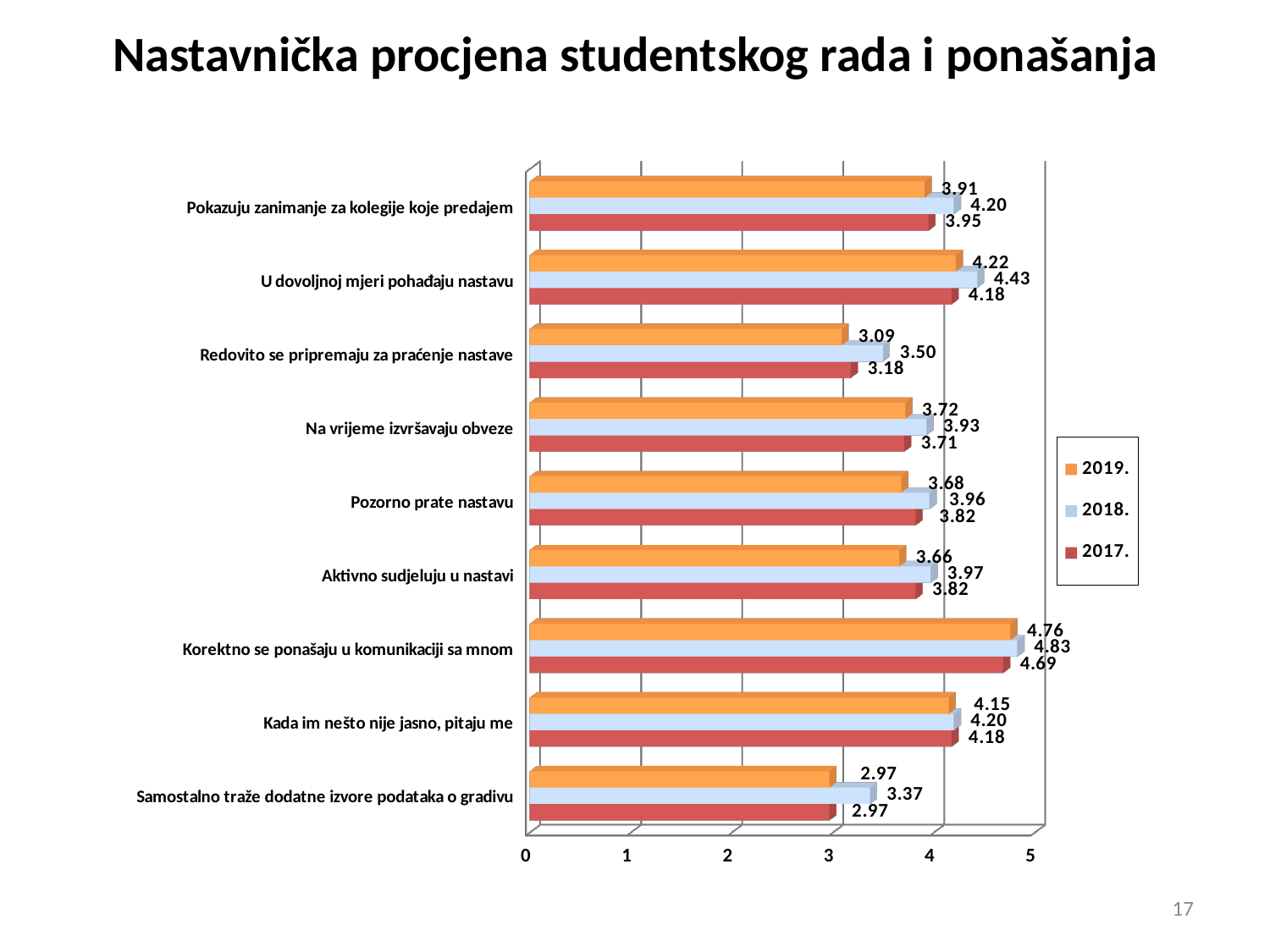
What is the 2019. value for "Pozorno prate nastavu"? 3.68 What is the 2018. value for "Redovito se pripremaju za praćenje nastave"? 3.50 What is the 2017. value for "Korektno se ponašaju u komunikaciji sa mnom"? 4.69 What is the difference between the 2018. and 2017. values for "Redovito se pripremaju za praćenje nastave"? 0.32 Which category has the highest 2019. value? Korektno se ponašaju u komunikaciji sa mnom How many series does the legend list? 3 How many categories are shown on the chart? 9 Which category has the lowest 2018. value? Samostalno traže dodatne izvore podataka o gradivu Is the 2019. value for "U dovoljnoj mjeri pohađaju nastavu" greater or less than 4? greater What kind of chart is shown on the slide? Bar chart What is the title of the slide? Nastavnička procjena studentskog rada i ponašanja Which is larger for "Aktivno sudjeluju u nastavi": the 2019. value or the 2018. value? 2018.